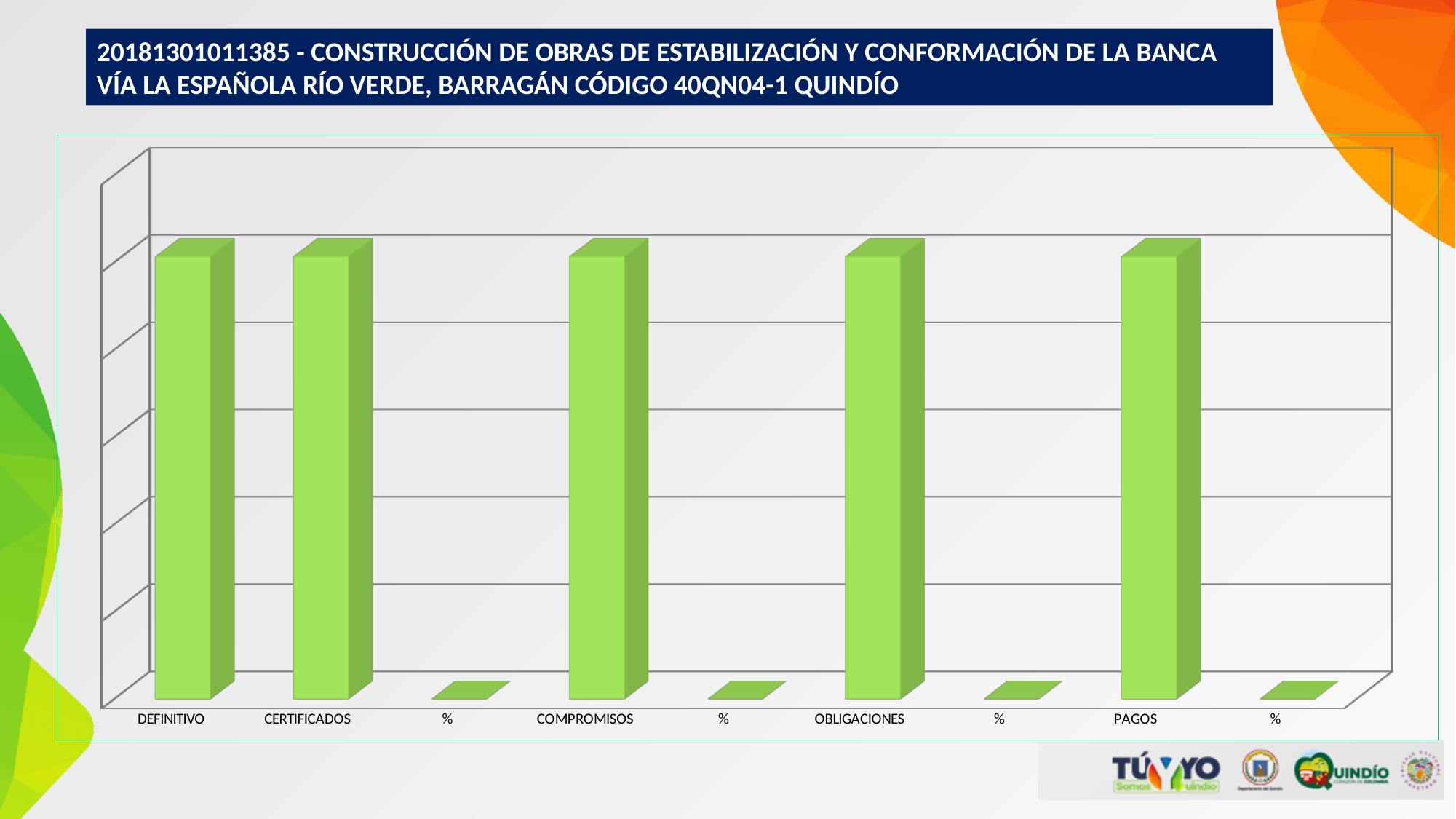
Which is larger, the value for PAGOS or the value for the % category immediately to its right? PAGOS Which is larger, the value for OBLIGACIONES or the value for the % category immediately to its right? OBLIGACIONES How many categories are shown along the x axis of the chart? 9 What is the label of the first category on the x axis of the chart? DEFINITIVO What colour are the bars in the chart? green Which is larger, the value for COMPROMISOS or the value for the % category immediately to its right? COMPROMISOS What kind of chart is shown on the slide? bar chart